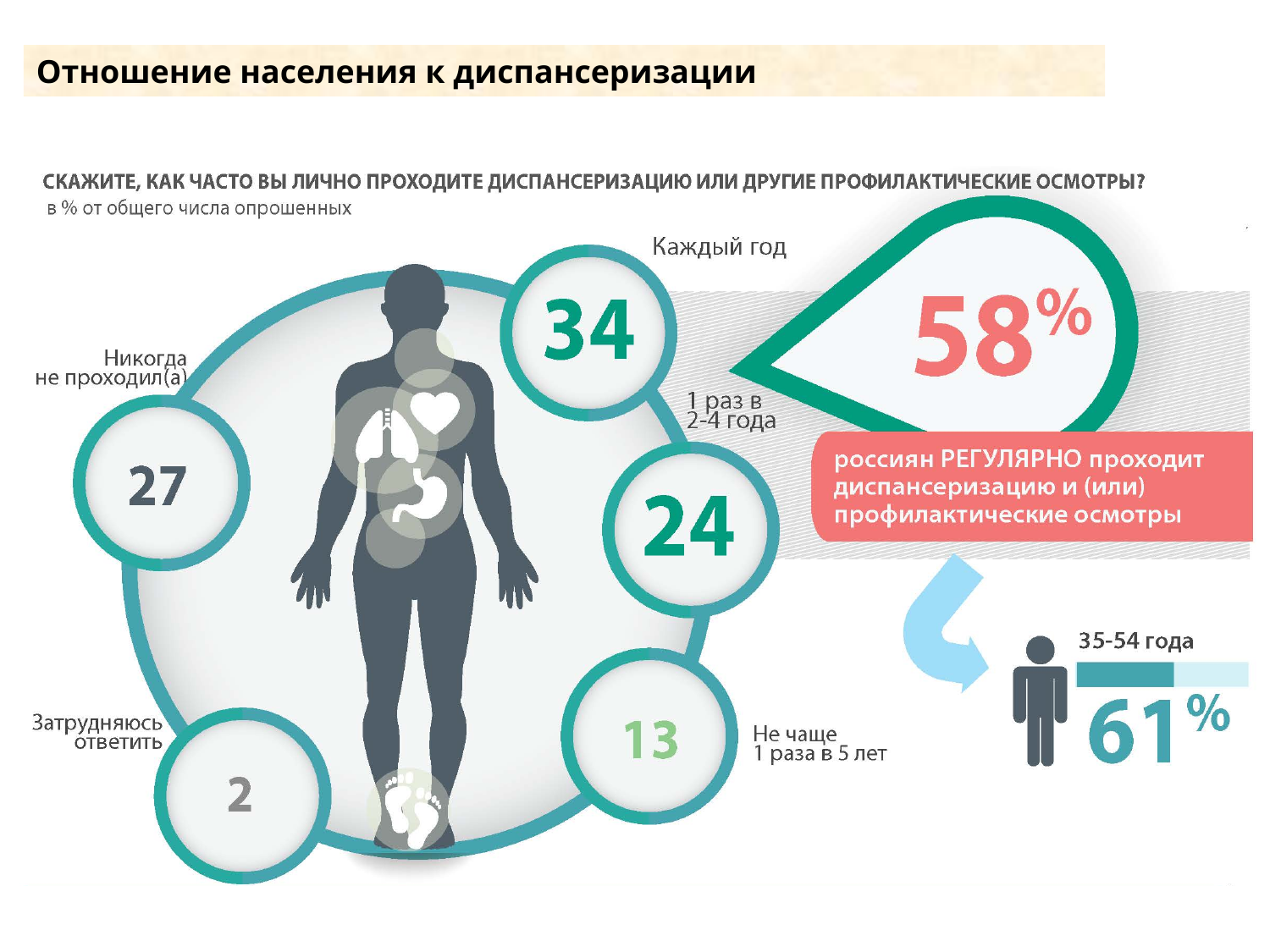
What percentage is shown for the 35-54 года age group? 61% What percentage of respondents said they undergo a check-up once every 2-4 years (1 раз в 2-4 года)? 24 Which is larger: the share answering '1 раз в 2-4 года' or the share answering 'Не чаще 1 раза в 5 лет'? 1 раз в 2-4 года What percentage of respondents said they have never undergone a check-up (Никогда не проходил(а))? 27 What percentage of Russians regularly undergo check-ups or preventive examinations, according to the highlighted callout? 58% What percentage of respondents said they undergo a check-up no more than once in 5 years (Не чаще 1 раза в 5 лет)? 13 What percentage of respondents said they undergo a check-up every year (Каждый год)? 34 Which response option has the lowest share of respondents? Затрудняюсь ответить How many response options are shown in the circles around the figure? 5 What is the difference between the share answering 'Каждый год' and the share answering 'Никогда не проходил(а)'? 7 What percentage of respondents found it difficult to answer (Затрудняюсь ответить)? 2 Which response option has the highest share of respondents? Каждый год